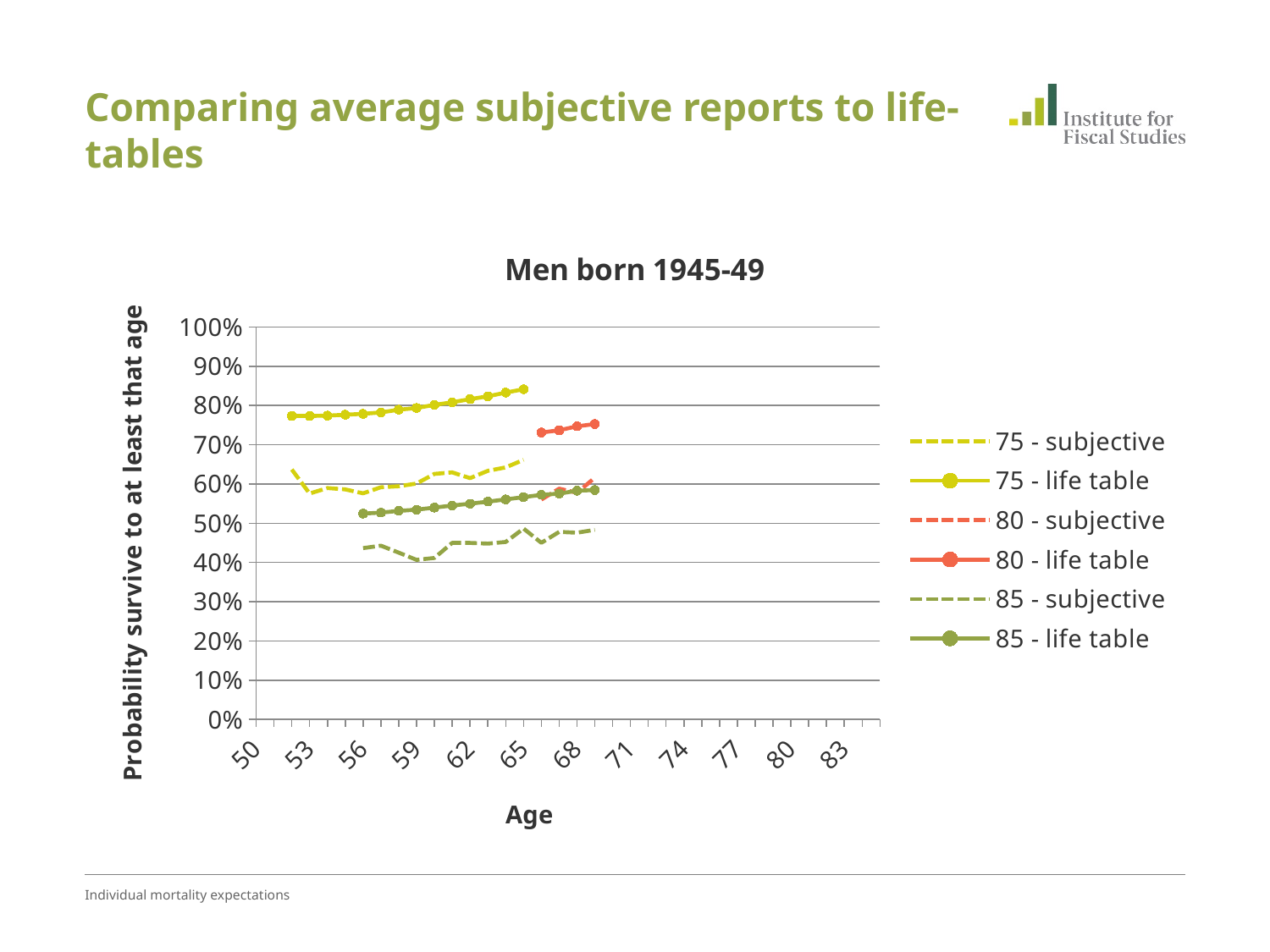
Is the value for the 80 - life table series at age 69 greater or less than 70%? greater Is the value for the 85 - subjective series at age 59 greater or less than 50%? less What kind of chart is shown on the slide? line chart How many series does the legend list? 6 Does the 85 - life table series rise or fall as age increases? rises Is the value for the 75 - life table series at age 52 greater or less than 70%? greater What is the title of the chart? Men born 1945-49 At age 67, which is larger: the 80 - life table value or the 85 - life table value? 80 - life table At age 65, which is larger: the 75 - life table value or the 75 - subjective value? 75 - life table Does the 75 - life table series rise or fall as age increases? rises What is the label on the vertical axis of the chart? Probability survive to at least that age